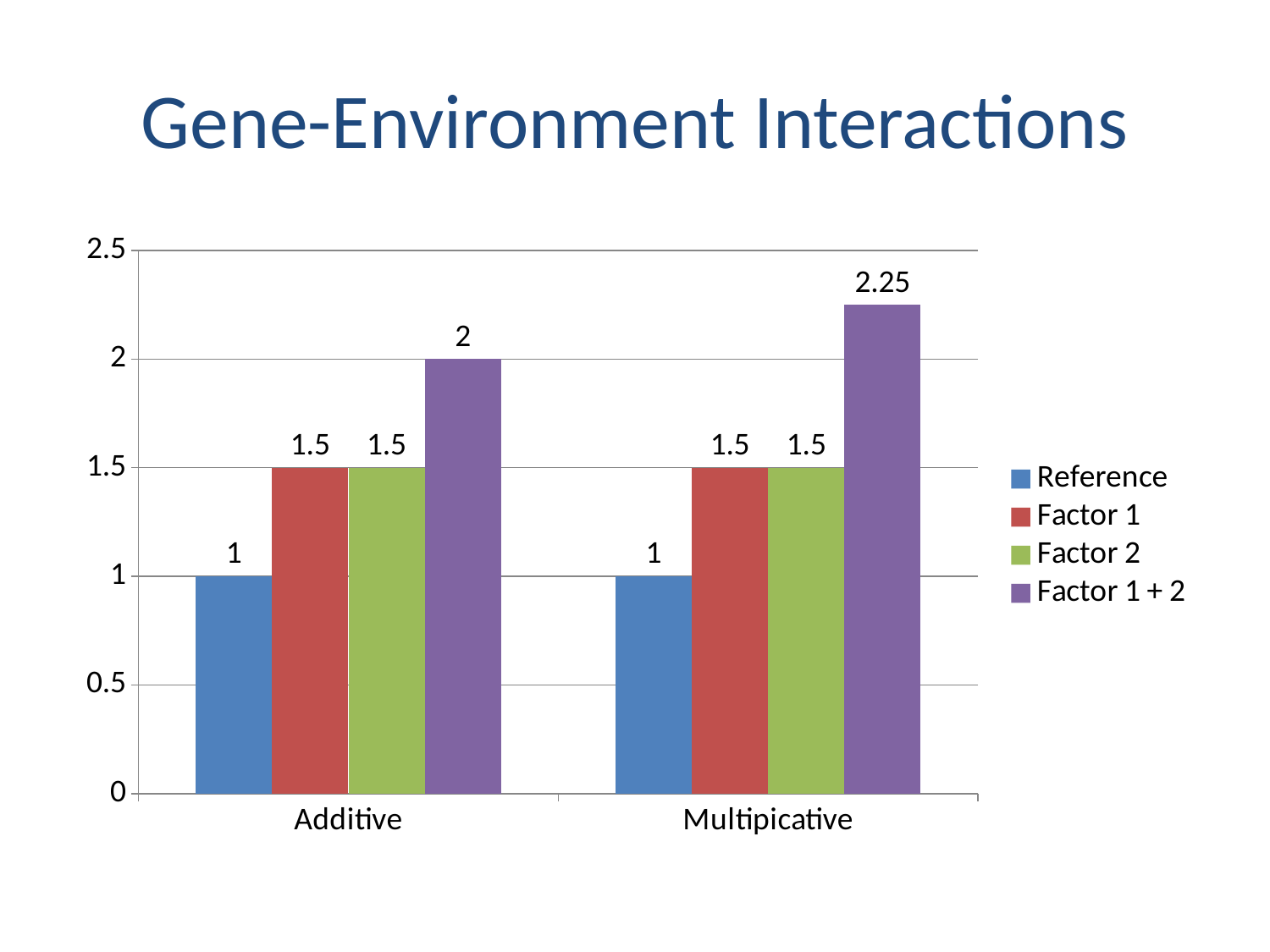
How many series does the legend list? 4 Which is larger: Factor 1 + 2 for Additive or Factor 1 + 2 for Multipicative? Multipicative What is the value of Factor 2 for the Multipicative category? 1.5 How many categories are shown on the x axis? 2 What is the value of Reference for the Additive category? 1 What is the value of Factor 1 + 2 for the Additive category? 2 What kind of chart is shown on the slide? Bar chart What is the difference between the Factor 1 + 2 values for Multipicative and Additive? 0.25 What is the value of Factor 1 + 2 for the Multipicative category? 2.25 What is the difference between Factor 1 + 2 and Reference in the Additive category? 1 Which series has the lowest value in the Additive category? Reference Which series has the highest value in the Multipicative category? Factor 1 + 2